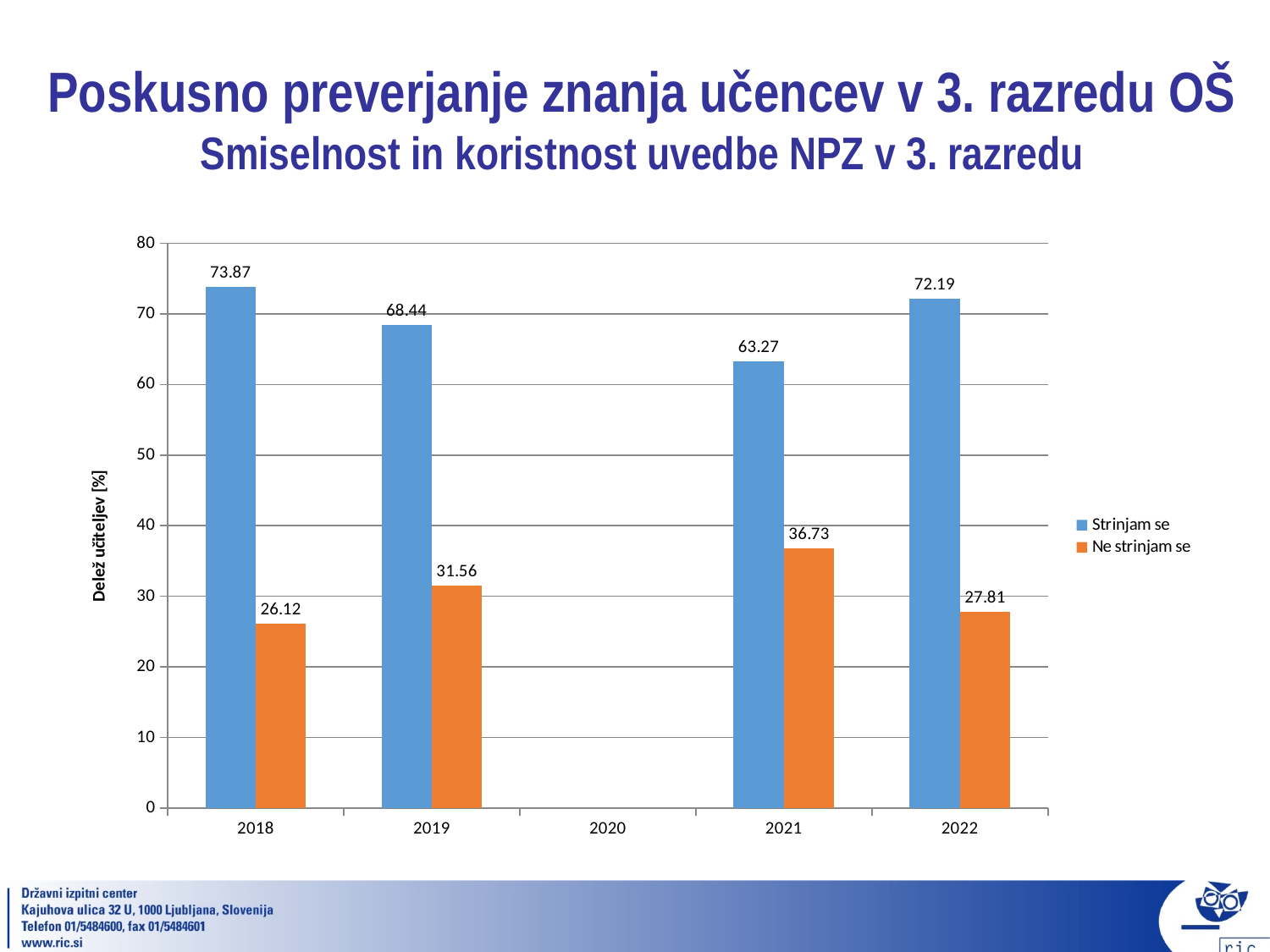
Which is larger: the "Ne strinjam se" value in 2018 or in 2022? 2022 What is the value for "Strinjam se" in 2022? 72.19 In which year is the "Strinjam se" value lowest? 2021 What is the label of the y axis? Delež učiteljev [%] What is the value for "Strinjam se" in 2018? 73.87 What is the value for "Ne strinjam se" in 2021? 36.73 Is the "Strinjam se" value for 2021 greater or less than 60? greater How many series does the legend list? 2 What kind of chart is shown on the slide? bar chart What is the difference between the "Strinjam se" and "Ne strinjam se" values in 2019? 36.88 In which year is the "Ne strinjam se" value highest? 2021 Which year on the x axis has no bars plotted? 2020